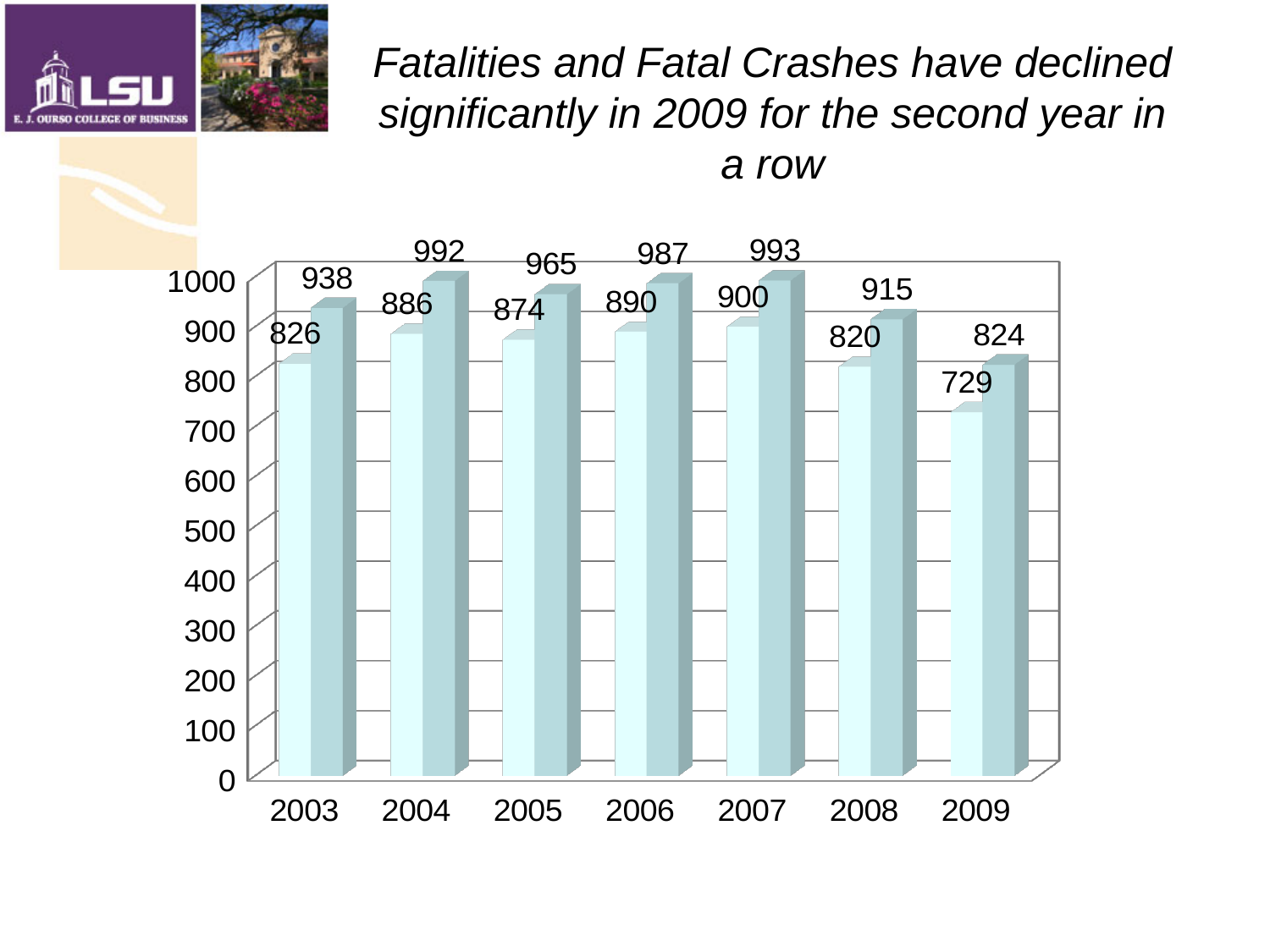
Is the value of the lighter bar for 2009 greater or less than 800? less In which year is the lighter (front) bar lowest? 2009 What is the difference between the darker bar and the lighter bar for 2009? 95 How many years are shown on the x axis? 7 What is the value of the lighter (front) bar for 2009? 729 What is the value of the lighter (front) bar for 2004? 886 What kind of chart is shown on the slide? bar chart What is the difference between the lighter bar for 2008 and the lighter bar for 2009? 91 In which year is the darker (back) bar lowest? 2009 What is the value of the darker (back) bar for 2003? 938 What is the value of the darker (back) bar for 2007? 993 Which is larger, the lighter bar for 2003 or the lighter bar for 2009? 2003